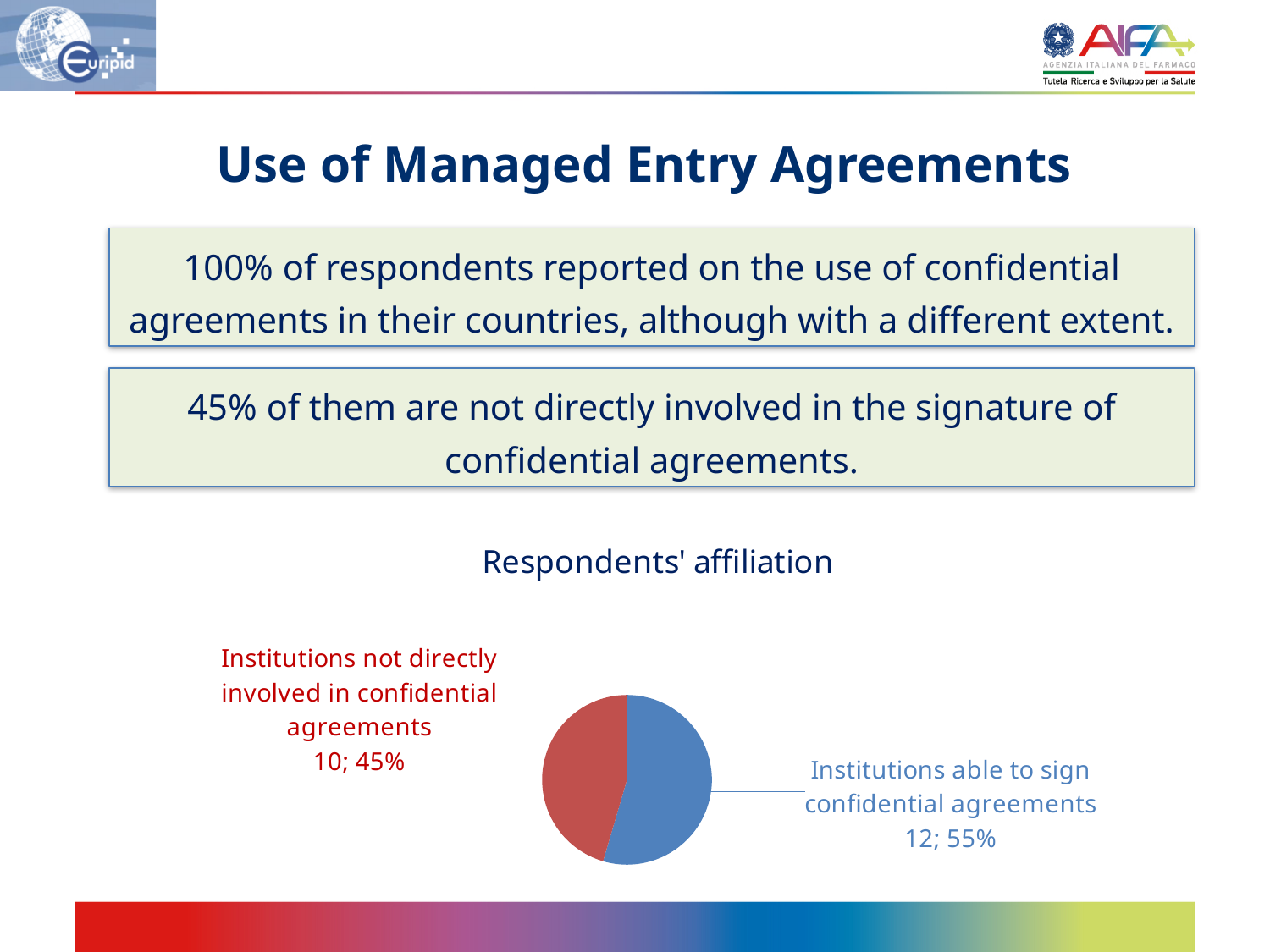
How many respondents are from institutions able to sign confidential agreements? 12 Which slice is the smallest? Institutions not directly involved in confidential agreements What is the total number of respondents shown in the pie chart? 22 How many respondents are from institutions not directly involved in confidential agreements? 10 What share of the pie is 'Institutions able to sign confidential agreements'? 55% What share of the pie is 'Institutions not directly involved in confidential agreements'? 45% How many slices does the pie chart have? 2 Which slice is the largest? Institutions able to sign confidential agreements What is the title of the chart? Respondents' affiliation What is the difference in respondent count between institutions able to sign confidential agreements and those not directly involved? 2 Which is larger: the count for institutions able to sign confidential agreements or for institutions not directly involved? Institutions able to sign confidential agreements What kind of chart is shown on the slide? Pie chart